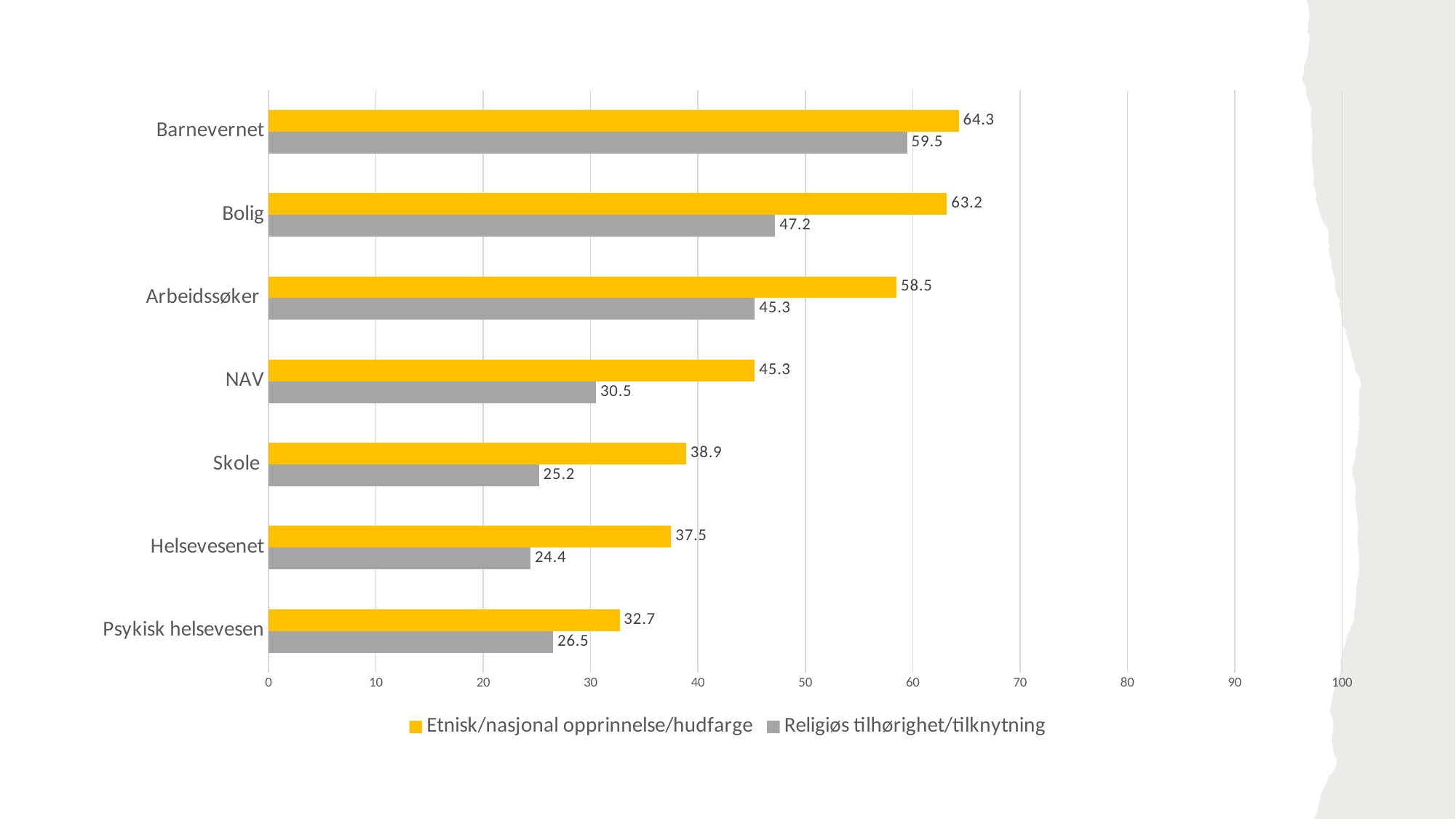
Is the Etnisk/nasjonal opprinnelse/hudfarge value for Psykisk helsevesen greater or less than 30? greater What is the value for Barnevernet in the Etnisk/nasjonal opprinnelse/hudfarge series? 64.3 Which category has the highest value in the Etnisk/nasjonal opprinnelse/hudfarge series? Barnevernet What is the value for Skole in the Religiøs tilhørighet/tilknytning series? 25.2 What is the difference between the Etnisk/nasjonal opprinnelse/hudfarge and Religiøs tilhørighet/tilknytning values for Bolig? 16 Which category has the lowest value in the Religiøs tilhørighet/tilknytning series? Helsevesenet How many categories are shown on the chart? 7 Which colour represents the Religiøs tilhørighet/tilknytning series? Grey How many series does the legend list? 2 Which is larger: the Religiøs tilhørighet/tilknytning value for Arbeidssøker or for Bolig? Bolig What kind of chart is shown on the slide? Bar chart What is the value for NAV in the Religiøs tilhørighet/tilknytning series? 30.5